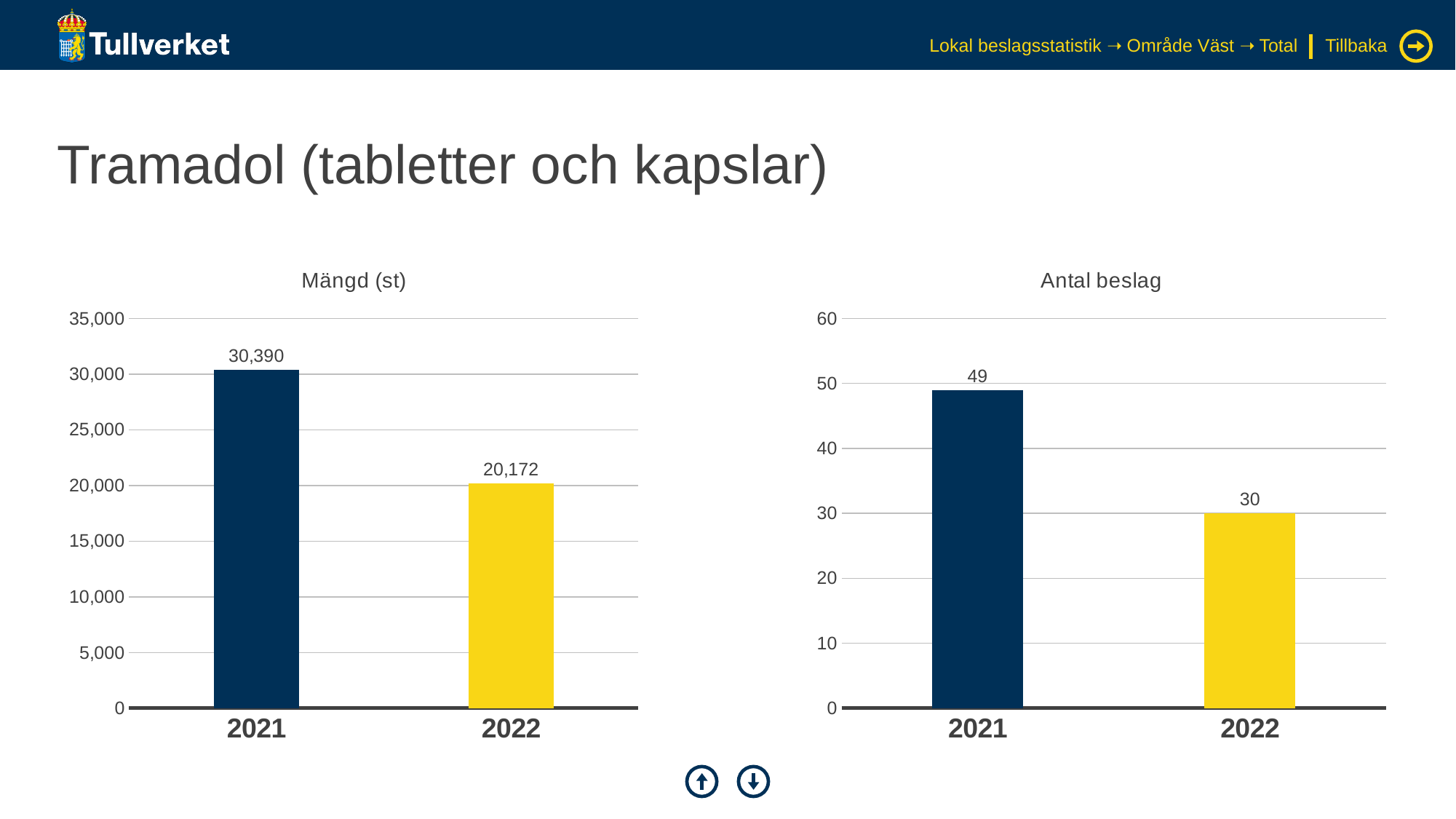
In the 'Antal beslag' chart, what is the difference between the 2021 and 2022 values? 19 In the 'Mängd (st)' chart, do the values rise or fall from 2021 to 2022? fall In the 'Mängd (st)' chart, what is the value for 2021? 30,390 How many years are shown in the 'Mängd (st)' chart? 2 In the 'Antal beslag' chart, which year has the lowest value? 2022 In the 'Antal beslag' chart, what is the value for 2022? 30 In the 'Antal beslag' chart, what is the value for 2021? 49 What kind of chart is the 'Antal beslag' chart? bar chart In the 'Mängd (st)' chart, what is the difference between the 2021 and 2022 values? 10,218 In the 'Mängd (st)' chart, what is the value for 2022? 20,172 In the 'Antal beslag' chart, is the value for 2021 greater or less than 40? greater In the 'Mängd (st)' chart, which year has the highest value? 2021